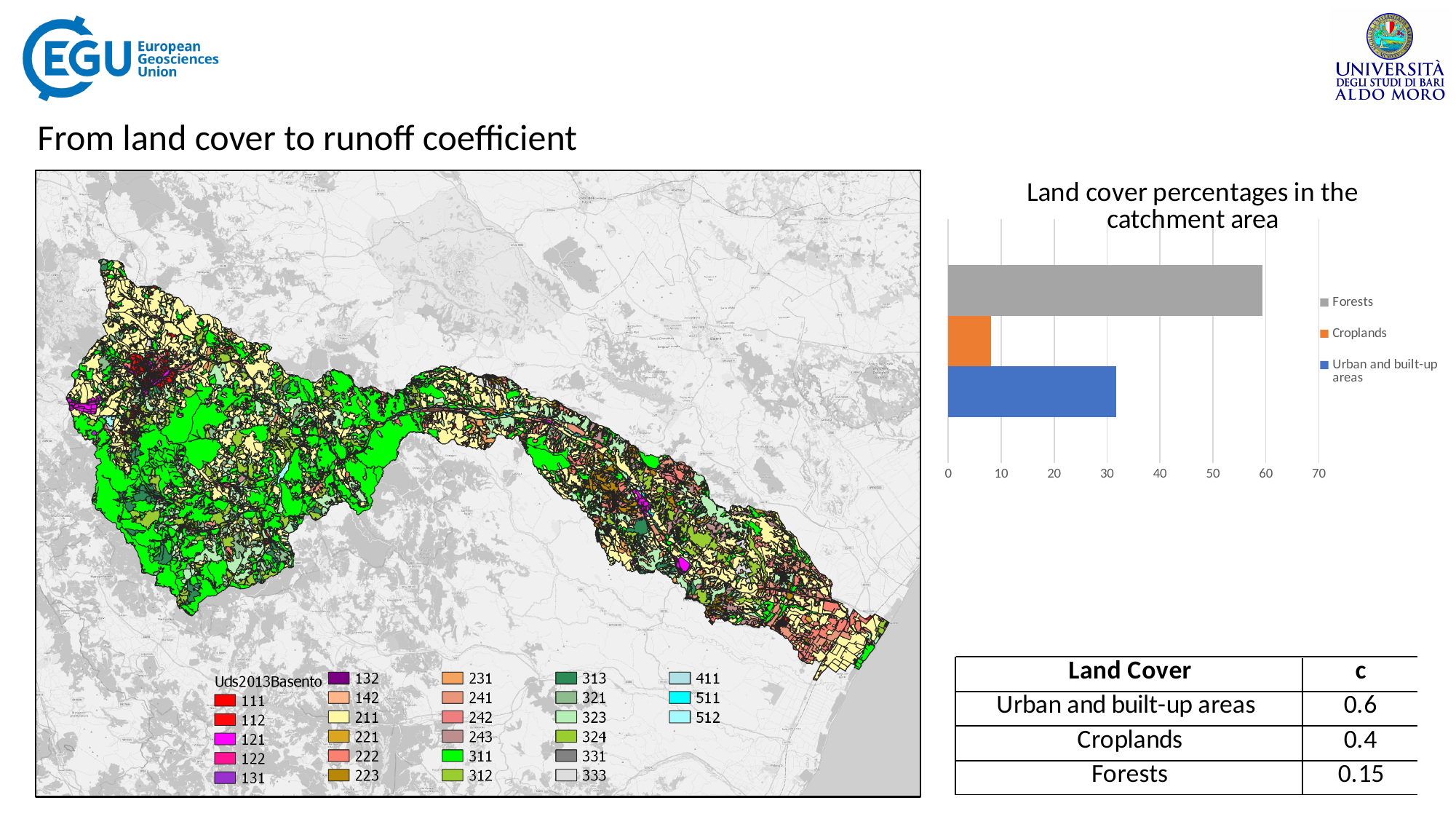
How many bars are plotted in the chart? 3 Is the value for Croplands greater or less than 20? less Which land cover class has the lowest percentage in the chart? Croplands What colour is the Forests bar in the chart? grey Is the value for Urban and built-up areas greater or less than 40? less What kind of chart is shown on the slide? bar chart What is the title of the chart on the slide? Land cover percentages in the catchment area Which land cover class has the highest percentage in the chart? Forests How many series does the chart legend list? 3 Which is larger in the chart, the value for Croplands or the value for Urban and built-up areas? Urban and built-up areas Is the value for Forests greater or less than 50? greater